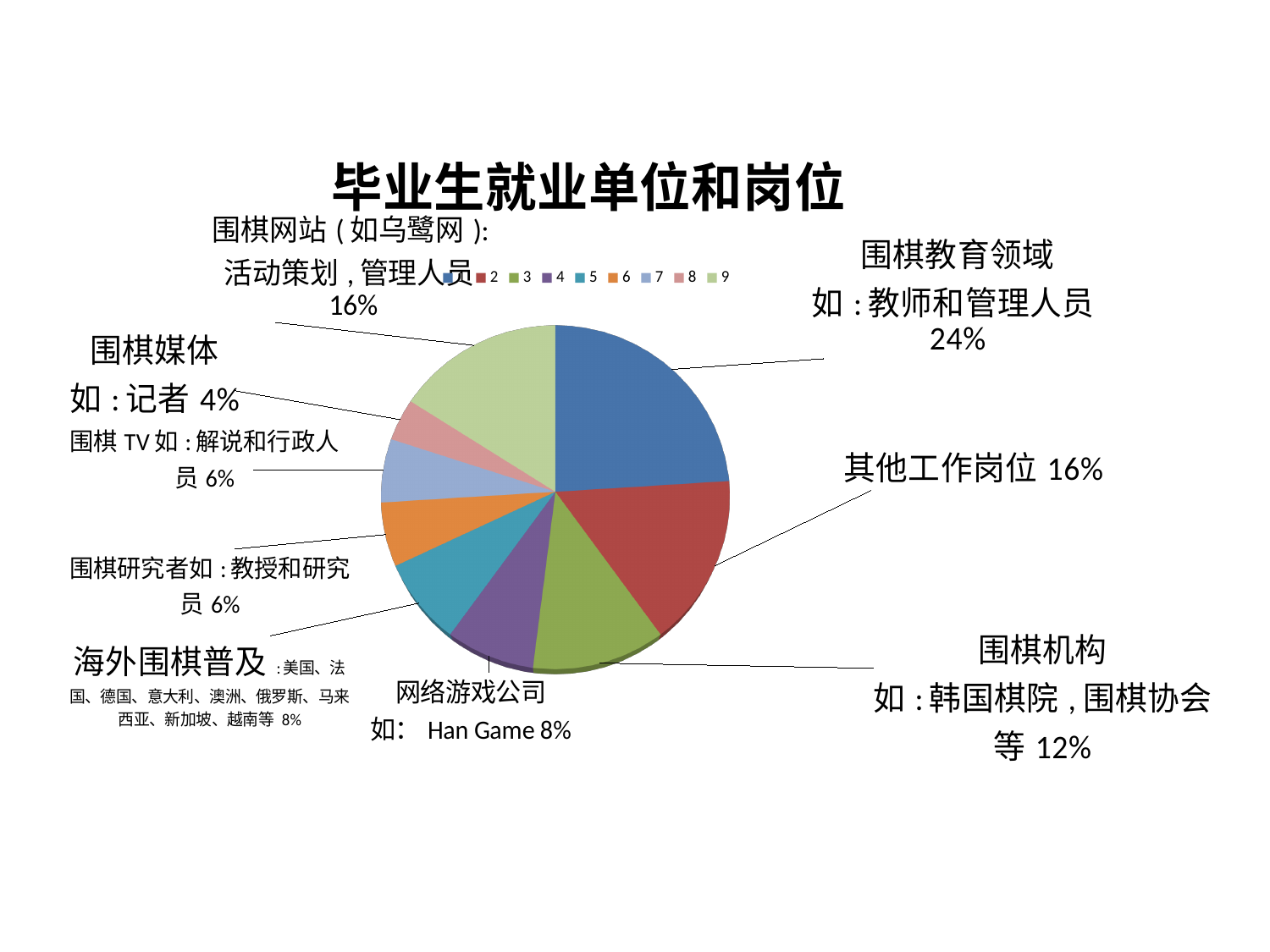
Which category has the largest share of the pie? 围棋教育领域 What is the difference in percentage points between 围棋教育领域 (24%) and 围棋机构 (12%)? 12 What percentage is shown for 网络游戏公司 (Han Game)? 8% Which category has the smallest share of the pie? 围棋媒体 What share of the pie is labelled 围棋教育领域 (教师和管理人员)? 24% How many slices does the pie chart have? 9 What percentage is shown for 围棋机构 (韩国棋院, 围棋协会等)? 12% Which has a larger share: 围棋网站 or 海外围棋普及? 围棋网站 What is the title of the chart? 毕业生就业单位和岗位 What percentage is shown for 围棋媒体 (记者)? 4% What kind of chart is shown on the slide? pie chart What percentage is shown for 其他工作岗位? 16%